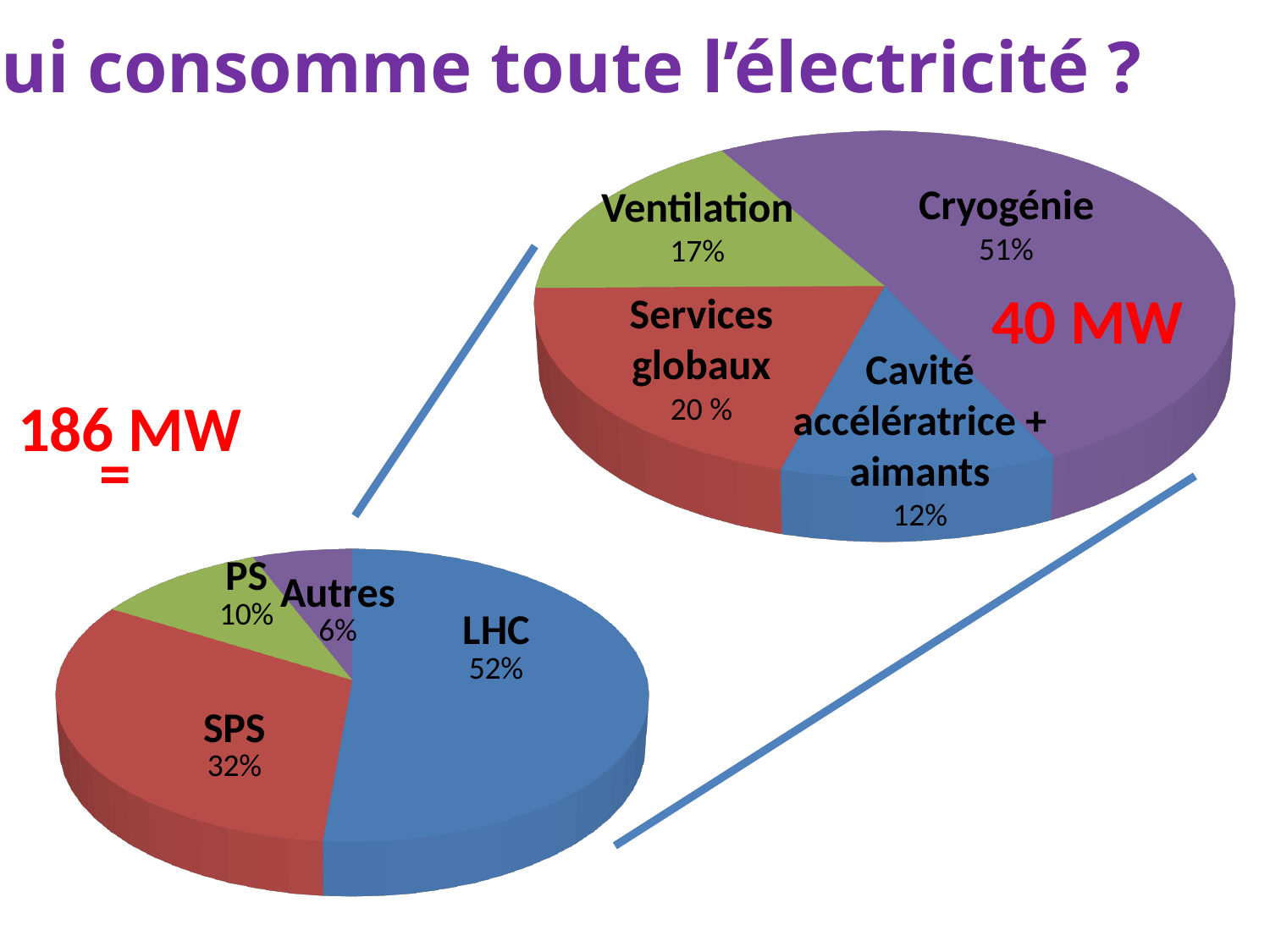
In the top-right pie chart, what share does Cavité accélératrice + aimants have? 12% In the bottom-left pie chart, what share does LHC have? 52% In the top-right pie chart, what share does Cryogénie have? 51% What type of chart is the bottom-left chart? Pie chart In the bottom-left pie chart, what is the difference in percentage points between LHC and SPS? 20 In the bottom-left pie chart, which category has the largest slice? LHC In the bottom-left pie chart, what share does SPS have? 32% In the top-right pie chart, which category has the smallest slice? Cavité accélératrice + aimants In the top-right pie chart, which is larger, Services globaux or Ventilation? Services globaux How many slices does the top-right pie chart have? 4 In the bottom-left pie chart, which category has the smallest slice? Autres In the top-right pie chart, what share does Ventilation have? 17%